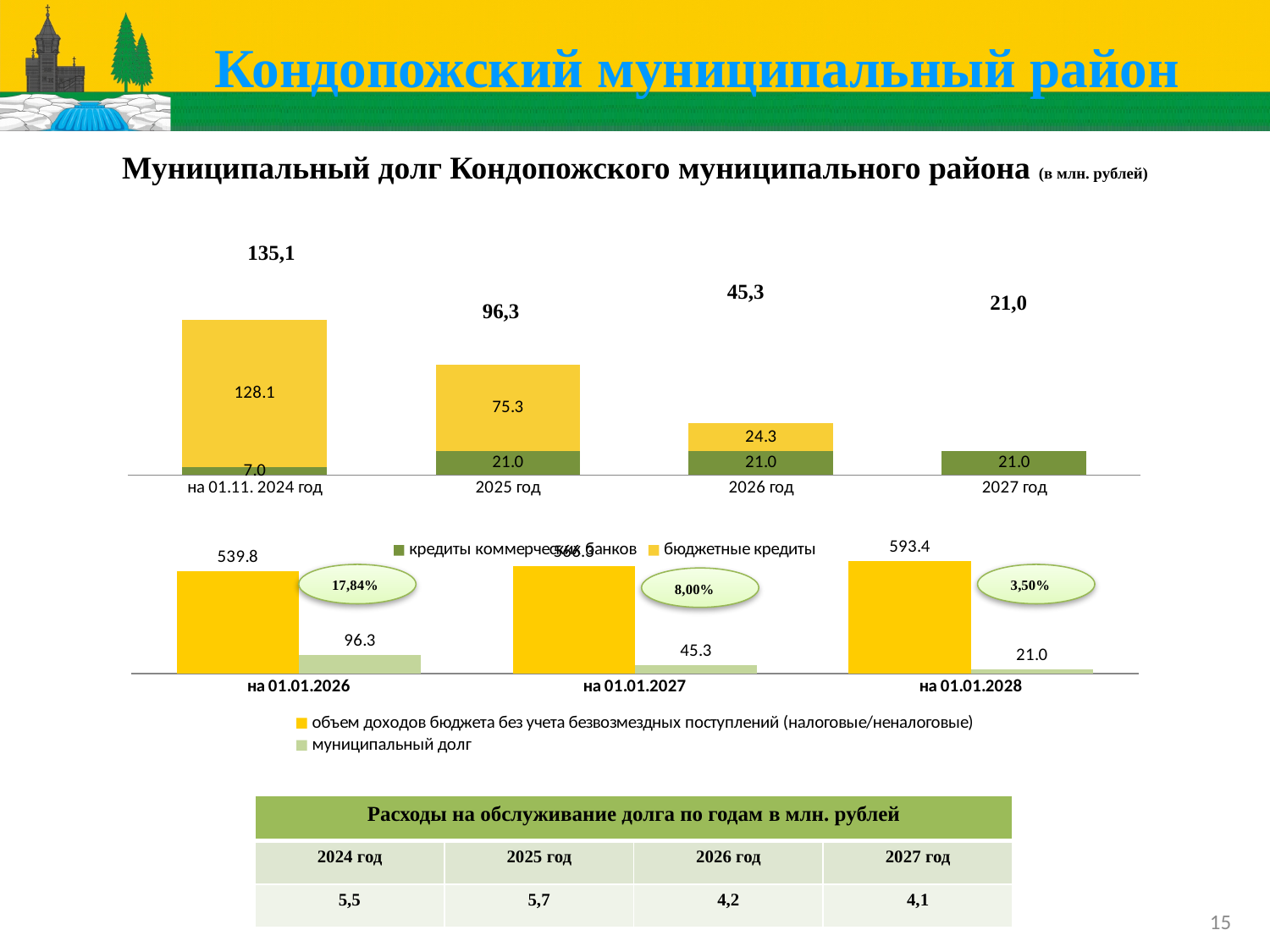
In the top chart (Муниципальный долг), what is the difference between бюджетные кредиты for 2025 год and 2026 год? 51.0 In the top chart (Муниципальный долг), what is the total municipal debt shown above the bar for 2026 год? 45,3 In the top chart (Муниципальный долг), what is the value of бюджетные кредиты for 2025 год? 75.3 In the bottom chart, what is the value of муниципальный долг for на 01.01.2027? 45.3 In the top chart (Муниципальный долг), what is the value of кредиты коммерческих банков for на 01.11. 2024 год? 7.0 In the bottom chart, what is the value of объем доходов бюджета без учета безвозмездных поступлений for на 01.01.2028? 593.4 In the top chart (Муниципальный долг), does the total debt rise or fall from на 01.11. 2024 год to 2027 год? fall In the top chart (Муниципальный долг), how many series does the legend list? 2 In the top chart (Муниципальный долг), which category has the lowest total debt? 2027 год What kind of chart is the bottom chart? bar chart In the top chart (Муниципальный долг), which category has the highest total debt? на 01.11. 2024 год In the bottom chart, which is larger for на 01.01.2026: объем доходов бюджета or муниципальный долг? объем доходов бюджета